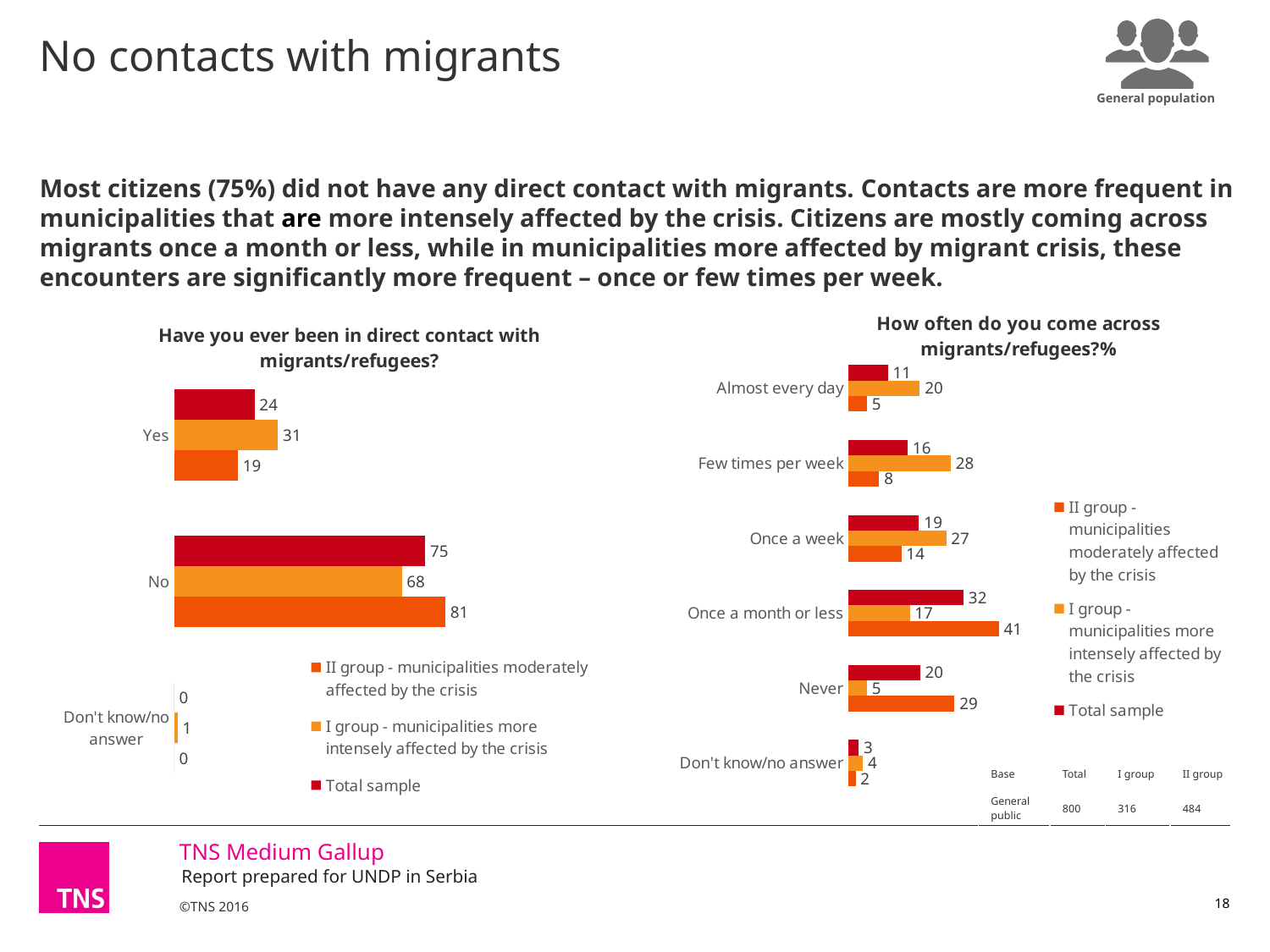
In the chart 'Have you ever been in direct contact with migrants/refugees?', what is the Total sample value for 'No'? 75 In the chart 'How often do you come across migrants/refugees?%', what is the Total sample value for 'Once a month or less'? 32 In the chart 'How often do you come across migrants/refugees?%', which category has the highest Total sample value? Once a month or less In the chart 'How often do you come across migrants/refugees?%', which category has the lowest Total sample value? Don't know/no answer In the chart 'How often do you come across migrants/refugees?%', which is larger for 'Few times per week': I group or II group? I group What kind of chart is 'How often do you come across migrants/refugees?%'? Bar chart In the chart 'Have you ever been in direct contact with migrants/refugees?', what is the difference between the Total sample values for 'No' and 'Yes'? 51 How many categories are shown in the chart 'How often do you come across migrants/refugees?%'? 6 In the chart 'Have you ever been in direct contact with migrants/refugees?', what is the value for 'No' in II group - municipalities moderately affected by the crisis? 81 In the chart 'How often do you come across migrants/refugees?%', what is the value for 'Never' in II group - municipalities moderately affected by the crisis? 29 In the chart 'Have you ever been in direct contact with migrants/refugees?', what is the value for 'Yes' in I group - municipalities more intensely affected by the crisis? 31 How many series does the legend list in the chart 'Have you ever been in direct contact with migrants/refugees?'? 3